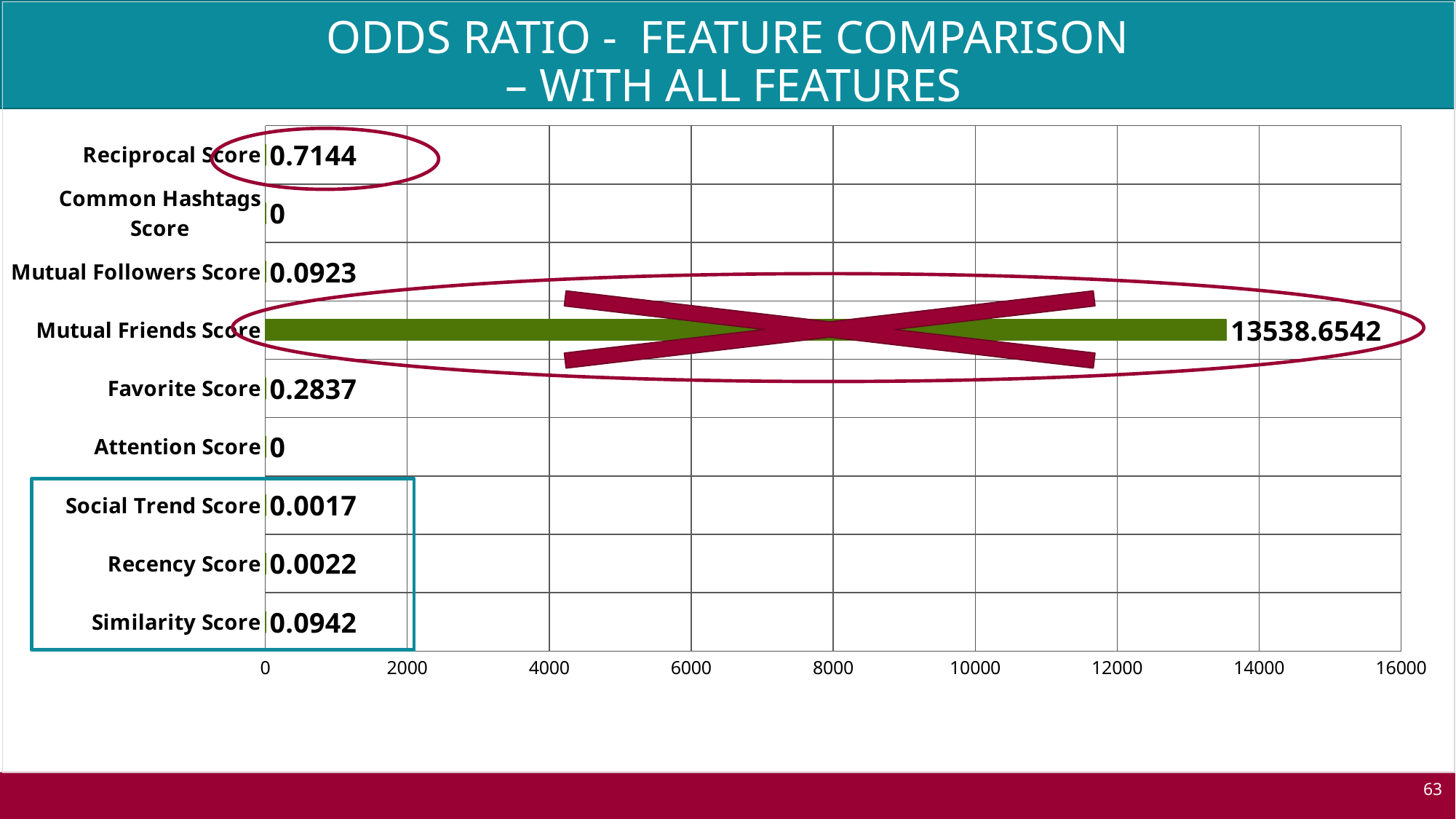
What is the value for Favorite Score? 0.2837 What is the value for Reciprocal Score? 0.7144 Which is larger, the value for Recency Score or the value for Social Trend Score? Recency Score What is the value for Recency Score? 0.0022 What is the difference between the values for Reciprocal Score and Favorite Score? 0.4307 Which category has the highest value? Mutual Friends Score What kind of chart is shown on the slide? bar chart How many categories are shown on the chart? 9 What is the difference between the values for Similarity Score and Mutual Followers Score? 0.0019 What is the value for Mutual Friends Score? 13538.6542 Is the value for Mutual Friends Score greater or less than 12000? greater What is the value for Similarity Score? 0.0942